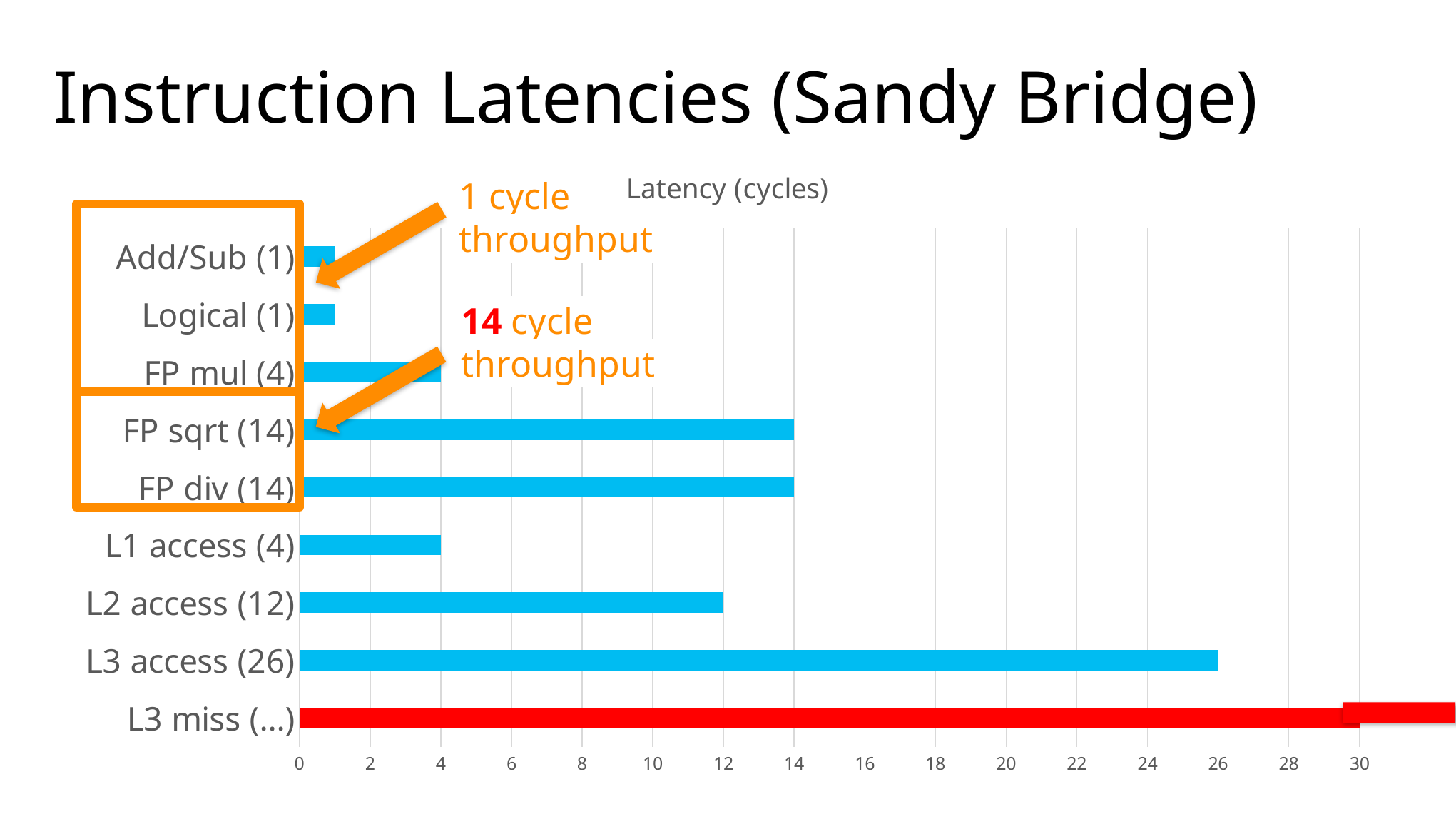
What is the latency in cycles for FP sqrt? 14 What kind of chart is shown on the slide? bar chart What is the latency in cycles for L2 access? 12 What is the difference in latency between FP sqrt and FP mul? 10 What is the difference in latency between L3 access and L2 access? 14 What colour is the bar for L3 miss? red Which category has the longest bar in the chart? L3 miss What is the latency in cycles for FP mul? 4 Is the value for L3 miss greater or less than 30? greater How many categories are plotted in the chart? 9 What is the latency in cycles for L3 access? 26 Which has the higher latency, FP div or L2 access? FP div